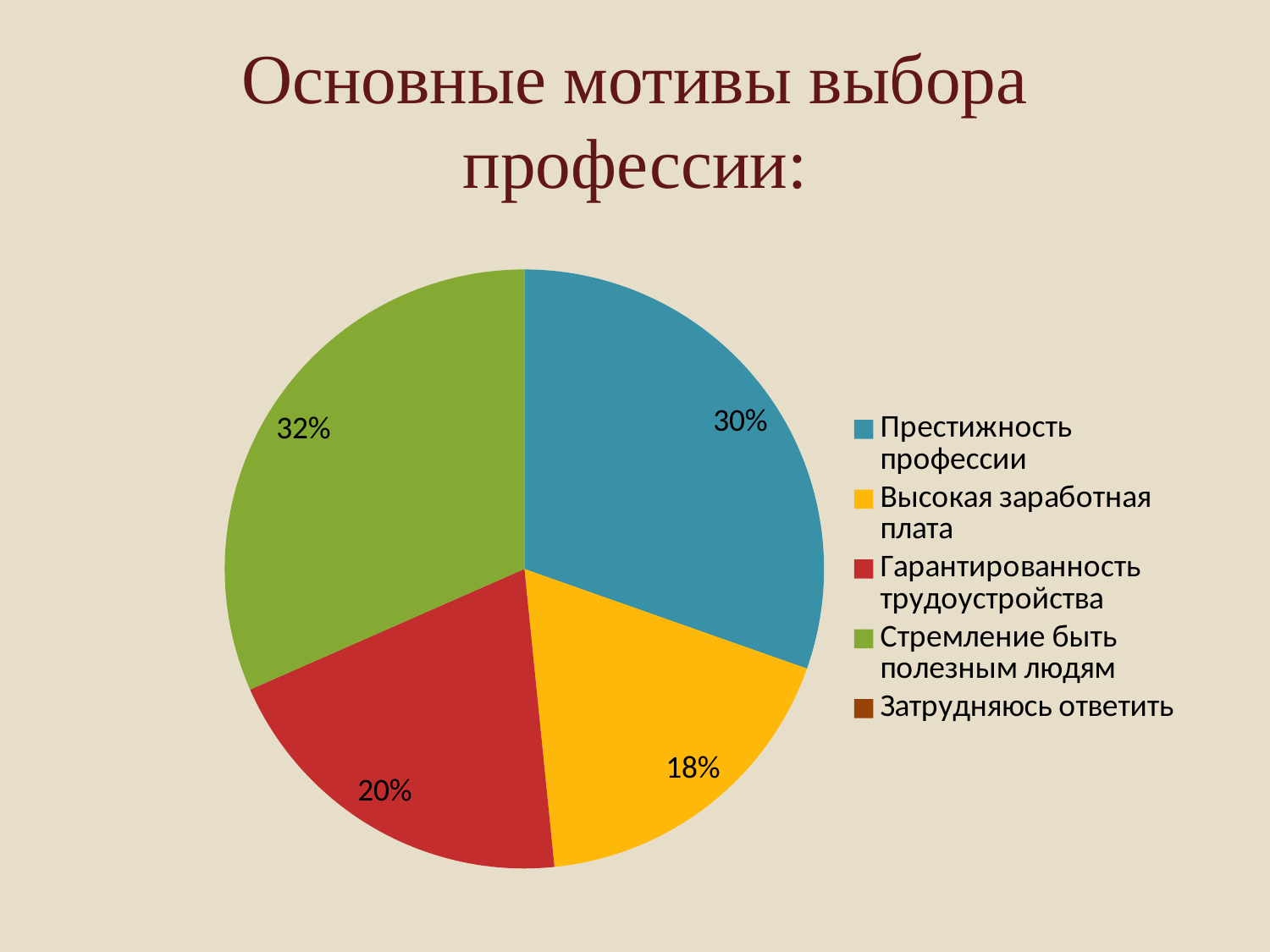
What share of the pie is labelled for "Стремление быть полезным людям"? 32% What is the difference in percentage points between "Стремление быть полезным людям" and "Высокая заработная плата"? 14 What share of the pie is labelled for "Высокая заработная плата"? 18% How many entries does the legend list? 5 Which motive has the largest slice of the pie? Стремление быть полезным людям What share of the pie is labelled for "Престижность профессии"? 30% What is the title of the chart on the slide? Основные мотивы выбора профессии: Which labelled slice of the pie is the smallest? Высокая заработная плата What colour is the slice for "Гарантированность трудоустройства"? Red Which is larger: the slice for "Престижность профессии" or the slice for "Гарантированность трудоустройства"? Престижность профессии What share of the pie is labelled for "Гарантированность трудоустройства"? 20% What kind of chart is shown on the slide? Pie chart